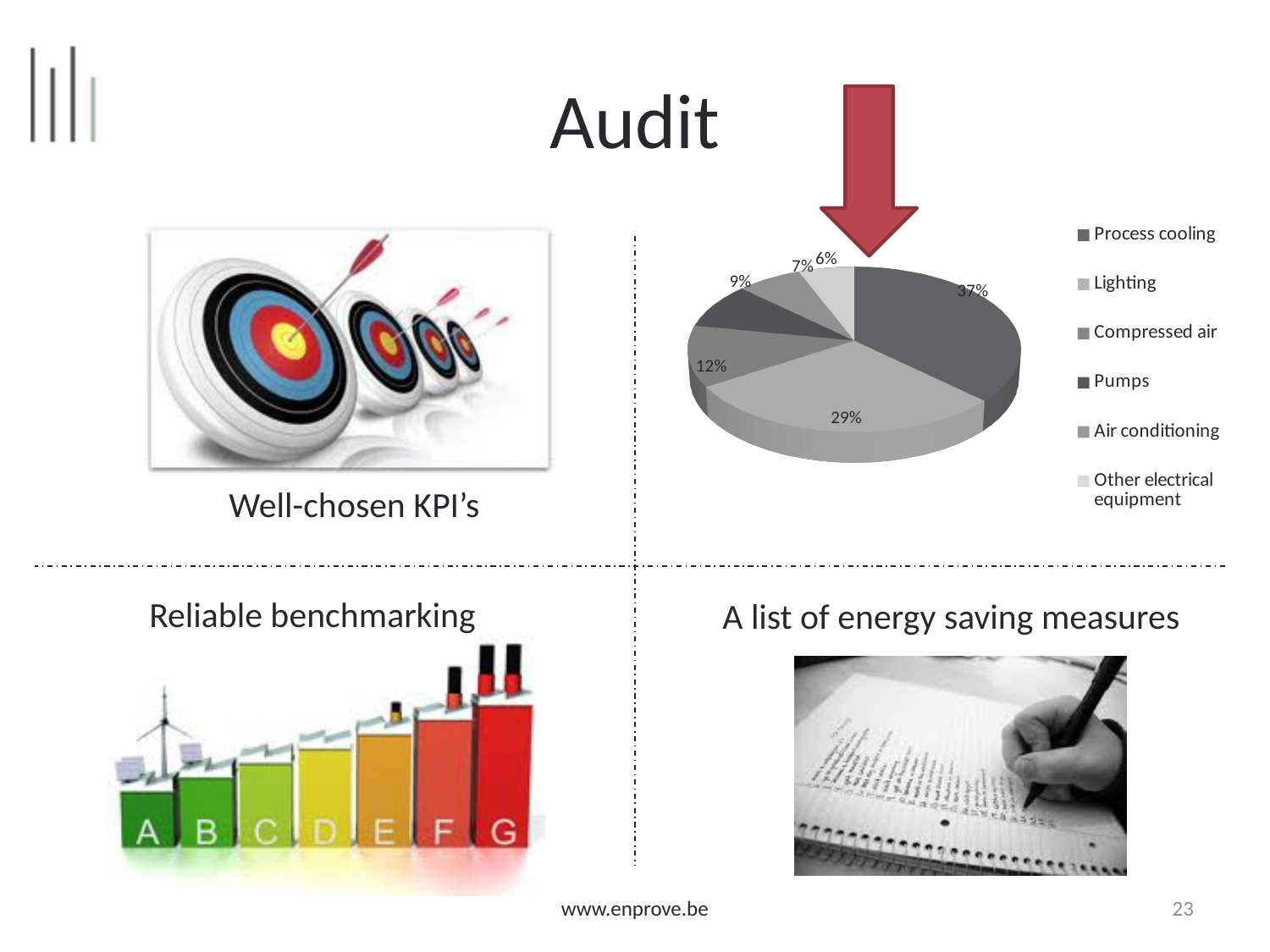
In the pie chart, what share does Pumps have? 9% Which category has the largest slice in the pie chart? Process cooling Which category has the smallest slice in the pie chart? Other electrical equipment How many categories does the pie chart's legend list? 6 In the pie chart, what share does Other electrical equipment have? 6% In the pie chart, what share does Process cooling have? 37% In the pie chart, what share does Compressed air have? 12% What type of chart is shown on the slide? Pie chart In the pie chart, what share does Lighting have? 29% In the pie chart, what is the difference between the shares of Process cooling and Lighting? 8% In the pie chart, which is larger: Compressed air or Air conditioning? Compressed air